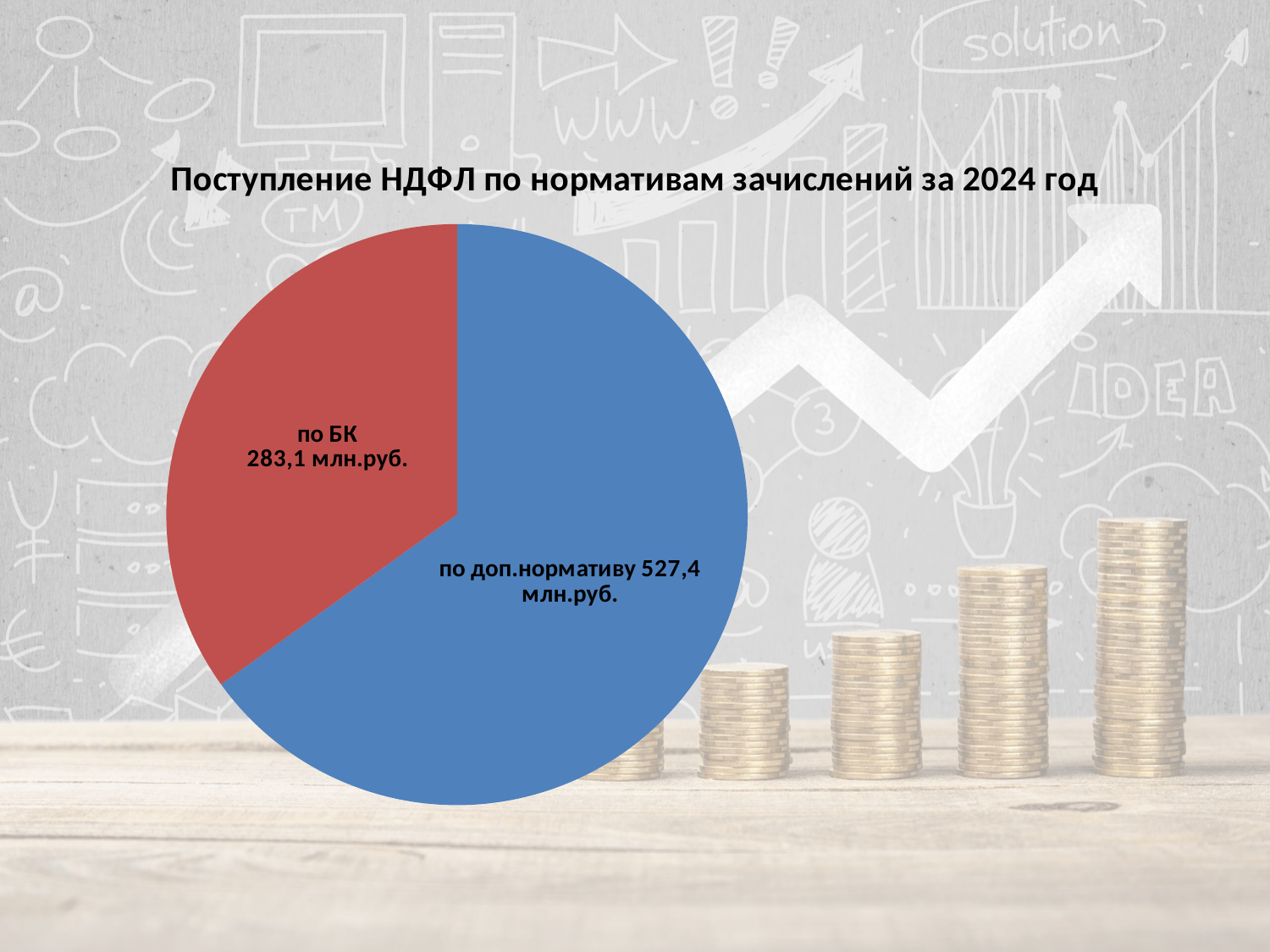
Which is larger, "по БК" or "по доп.нормативу"? по доп.нормативу What is the title of the chart? Поступление НДФЛ по нормативам зачислений за 2024 год How many slices does the pie chart have? 2 What is the value for "по БК"? 283,1 млн.руб. What is the total of the two slices? 810,5 млн.руб. Which slice is the largest? по доп.нормативу What colour is the "по БК" slice? red Which slice is the smallest? по БК What is the difference between "по доп.нормативу" and "по БК"? 244,3 млн.руб. What is the value for "по доп.нормативу"? 527,4 млн.руб. What kind of chart is shown on the slide? pie chart